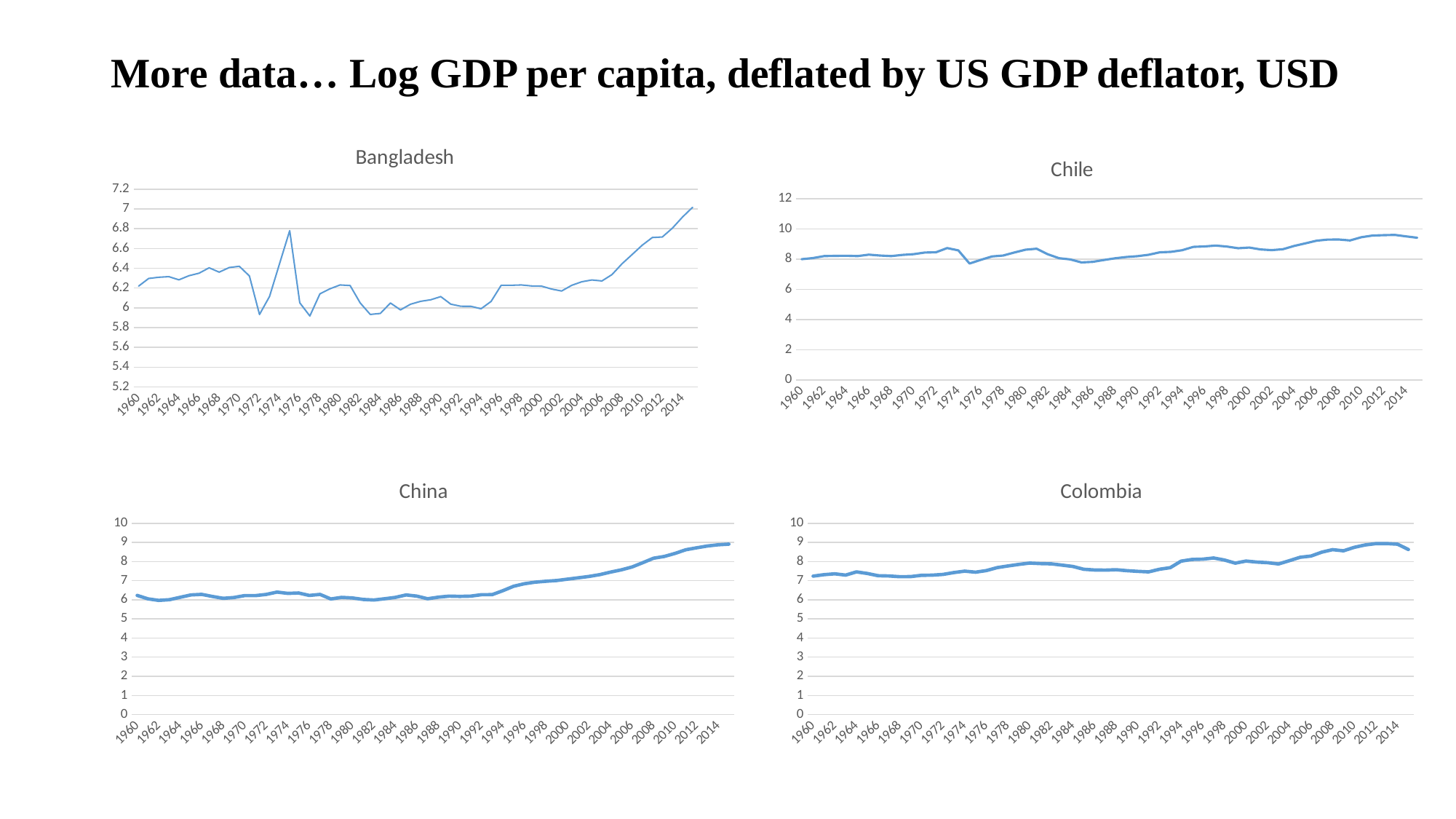
In the China chart, does the value rise or fall between 1994 and 2014? rise Which country's chart is in the top-right position of the slide? Chile How many charts are shown on the slide? 4 In the Bangladesh chart, is the value for 2014 greater or less than 6.8? greater In the Chile chart, is the overall trend from 1960 to 2014 rising or falling? rising In the China chart, is the value for 1960 greater or less than 8? less What is the title of the slide? More data… Log GDP per capita, deflated by US GDP deflator, USD What kind of chart is used for the Bangladesh panel? line chart In the Chile chart, is the value for 2014 greater or less than 8? greater In the China chart, which is larger: the value for 1960 or the value for 2014? 2014